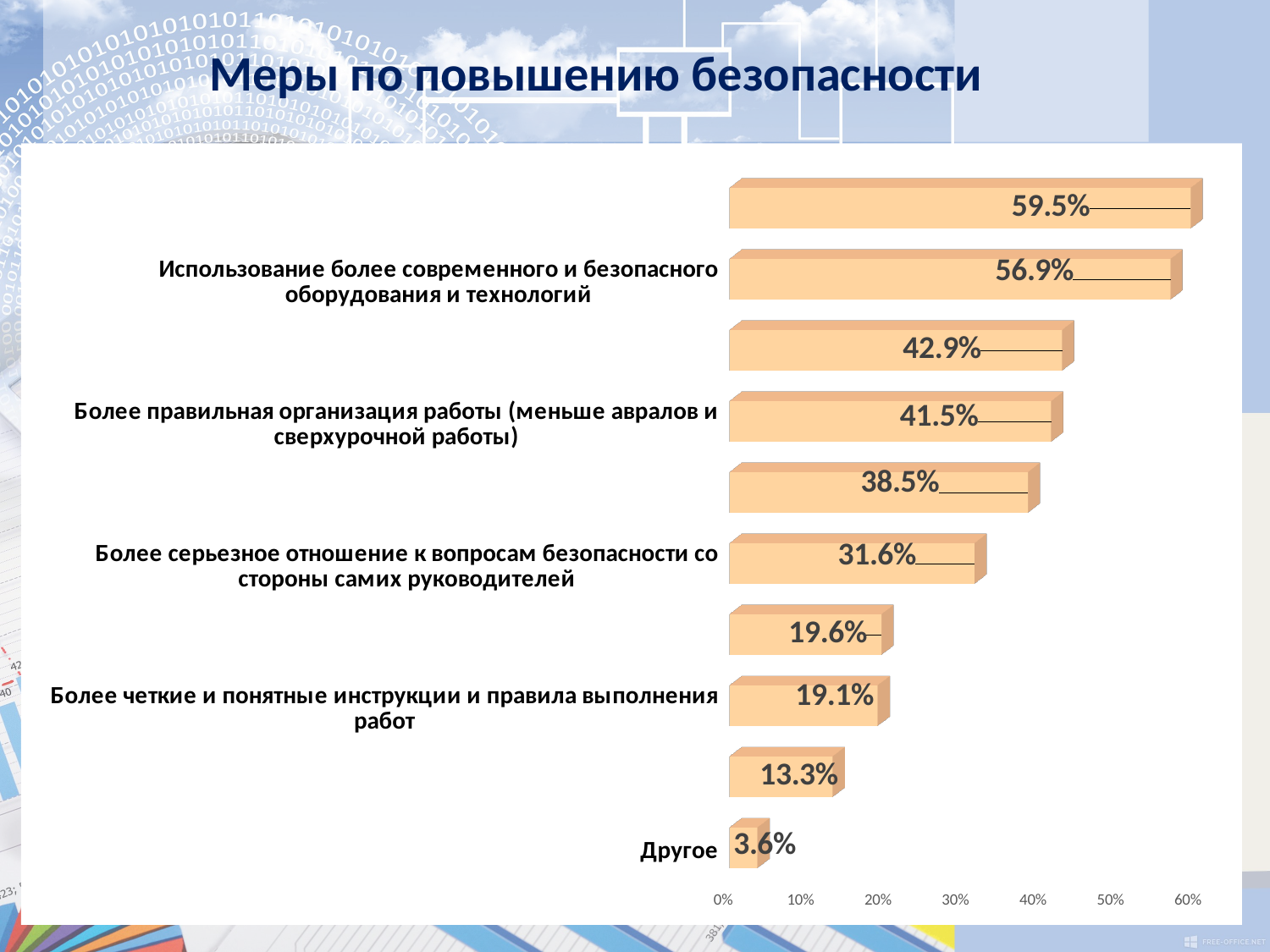
What is the difference between the values for "Использование более современного и безопасного оборудования и технологий" and "Более правильная организация работы (меньше авралов и сверхурочной работы)"? 15.4% What is the value for "Более серьезное отношение к вопросам безопасности со стороны самих руководителей"? 31.6% Which is larger: the value for "Более серьезное отношение к вопросам безопасности со стороны самих руководителей" or for "Более четкие и понятные инструкции и правила выполнения работ"? Более серьезное отношение к вопросам безопасности со стороны самих руководителей What kind of chart is shown on the slide? Bar chart How many bars are plotted on the chart? 10 What is the value for "Использование более современного и безопасного оборудования и технологий"? 56.9% What is the title of the slide? Меры по повышению безопасности What is the value for "Другое"? 3.6% What is the highest value shown on the chart? 59.5% What is the value for "Более четкие и понятные инструкции и правила выполнения работ"? 19.1% Which category has the lowest value? Другое What is the value for "Более правильная организация работы (меньше авралов и сверхурочной работы)"? 41.5%